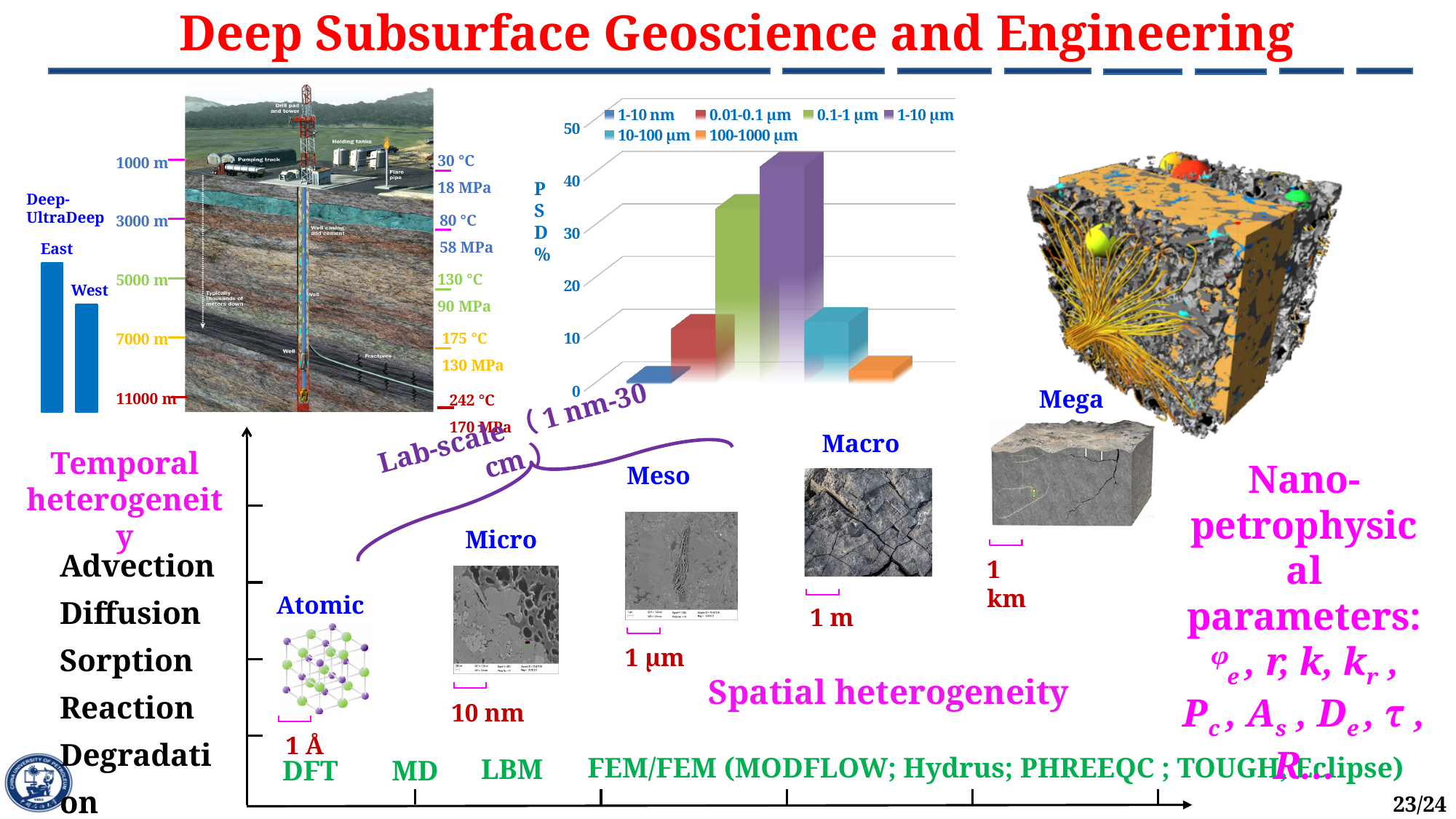
In the Deep-UltraDeep chart on the left of the slide, which bar is taller, East or West? East What kind of chart is the PSD % chart in the upper middle of the slide? bar chart In the PSD % chart, is the value for 1-10 µm greater or less than 40? greater What is the highest tick value shown on the vertical axis of the PSD % chart? 50 How many series does the legend of the PSD % chart list? 6 In the PSD % chart, which size range has the highest value? 1-10 µm In the PSD % chart, which is larger, the value for 0.1-1 µm or the value for 1-10 µm? 1-10 µm How many bars does the Deep-UltraDeep chart on the left of the slide show? 2 What is the label on the vertical axis of the PSD % chart? PSD % In the PSD % chart, is the value for 10-100 µm greater or less than 20? less In the PSD % chart, is the value for 0.1-1 µm greater or less than 30? greater